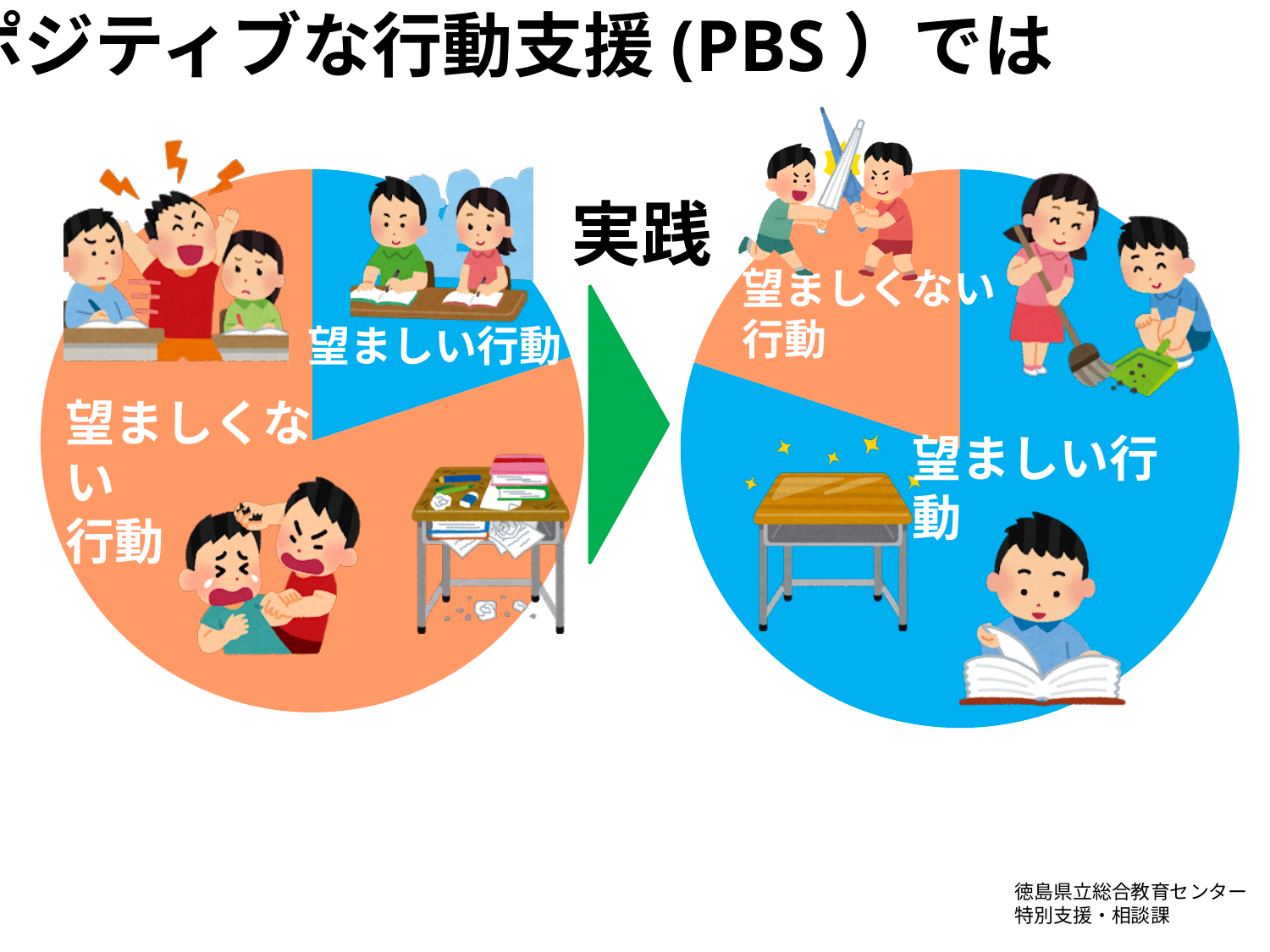
In the right pie chart, which slice is larger: 望ましくない行動 or 望ましい行動? 望ましい行動 In the left pie chart, which slice is the largest? 望ましくない行動 What kind of chart is the chart on the right side of the slide? pie chart In the right pie chart, which slice is the largest? 望ましい行動 What word is written above the arrow between the two pie charts? 実践 In the left pie chart, which slice is the smallest? 望ましい行動 How many slices does the left pie chart have? 2 In the left pie chart, which slice is larger: 望ましくない行動 or 望ましい行動? 望ましくない行動 What kind of chart is the chart on the left side of the slide? pie chart What colour is the 望ましい行動 slice in both pie charts? blue How many slices does the right pie chart have? 2 In the right pie chart, which slice is the smallest? 望ましくない行動